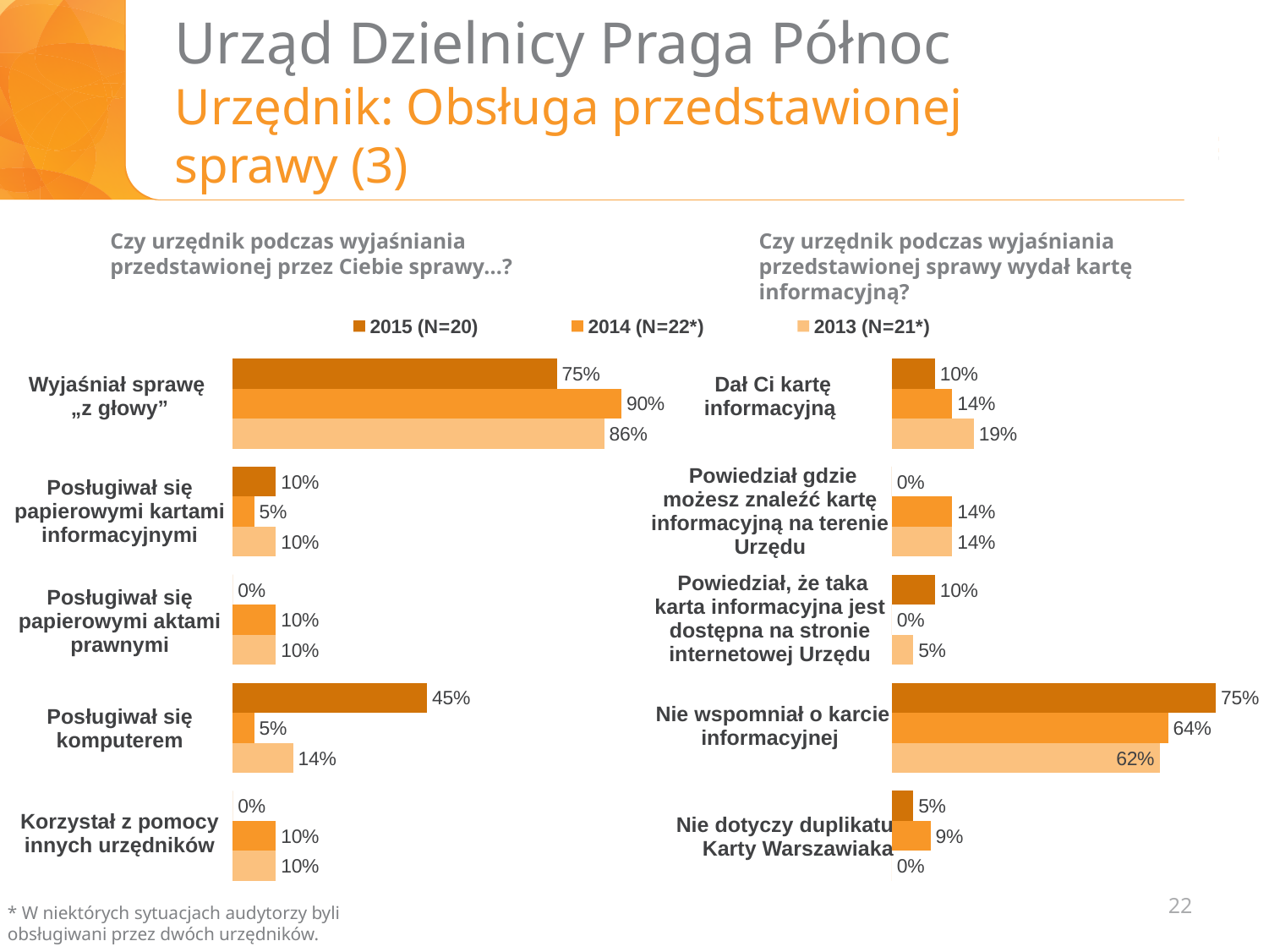
How many categories does the left chart show? 5 In the right chart, what is the 2014 (N=22*) value for "Nie wspomniał o karcie informacyjnej"? 64% In the left chart, what is the difference between the 2015 (N=20) and 2014 (N=22*) values for "Posługiwał się komputerem"? 40 percentage points In the left chart, what is the 2015 (N=20) value for "Posługiwał się komputerem"? 45% In the right chart, what is the 2015 (N=20) value for "Powiedział gdzie możesz znaleźć kartę informacyjną na terenie Urzędu"? 0% In the left chart, which category has the highest 2015 (N=20) value? Wyjaśniał sprawę „z głowy” How many series does the legend list? 3 In the right chart ("Czy urzędnik podczas wyjaśniania przedstawionej sprawy wydał kartę informacyjną?"), what is the 2013 (N=21*) value for "Dał Ci kartę informacyjną"? 19% In the right chart, which category has the lowest 2013 (N=21*) value? Nie dotyczy duplikatu Karty Warszawiaka In the right chart, which is larger for "Nie wspomniał o karcie informacyjnej": the 2015 (N=20) value or the 2013 (N=21*) value? 2015 (N=20) What type of chart is used on this slide? Bar chart In the left chart ("Czy urzędnik podczas wyjaśniania przedstawionej przez Ciebie sprawy...?"), what is the 2014 (N=22*) value for "Wyjaśniał sprawę „z głowy”"? 90%